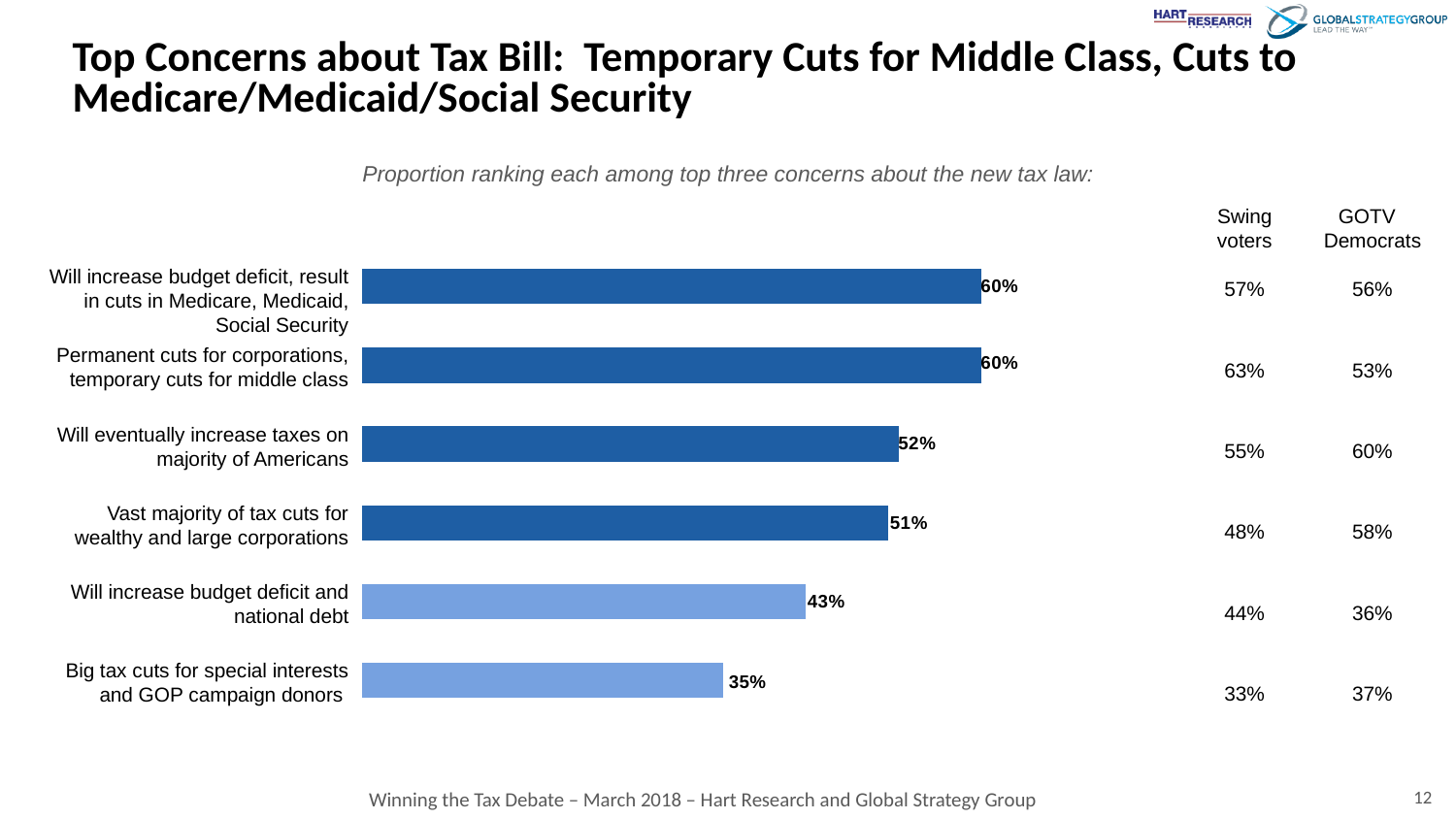
What is the difference between the value for 'Vast majority of tax cuts for wealthy and large corporations' and 'Will increase budget deficit and national debt'? 8% What is the highest value shown on the bars? 60% What is the Swing voters value for 'Permanent cuts for corporations, temporary cuts for middle class'? 63% Which is larger: the value for 'Will eventually increase taxes on majority of Americans' or 'Big tax cuts for special interests and GOP campaign donors'? Will eventually increase taxes on majority of Americans What is the value for 'Big tax cuts for special interests and GOP campaign donors'? 35% Which concern has the lowest proportion in the bar chart? Big tax cuts for special interests and GOP campaign donors What is the value for 'Will increase budget deficit and national debt'? 43% What is the GOTV Democrats value for 'Will increase budget deficit and national debt'? 36% How many concerns are listed in the bar chart? 6 Do the bar values rise or fall from the top of the chart to the bottom? Fall What percentage ranked 'Will eventually increase taxes on majority of Americans' among their top three concerns? 52% What kind of chart is shown on the slide? Bar chart